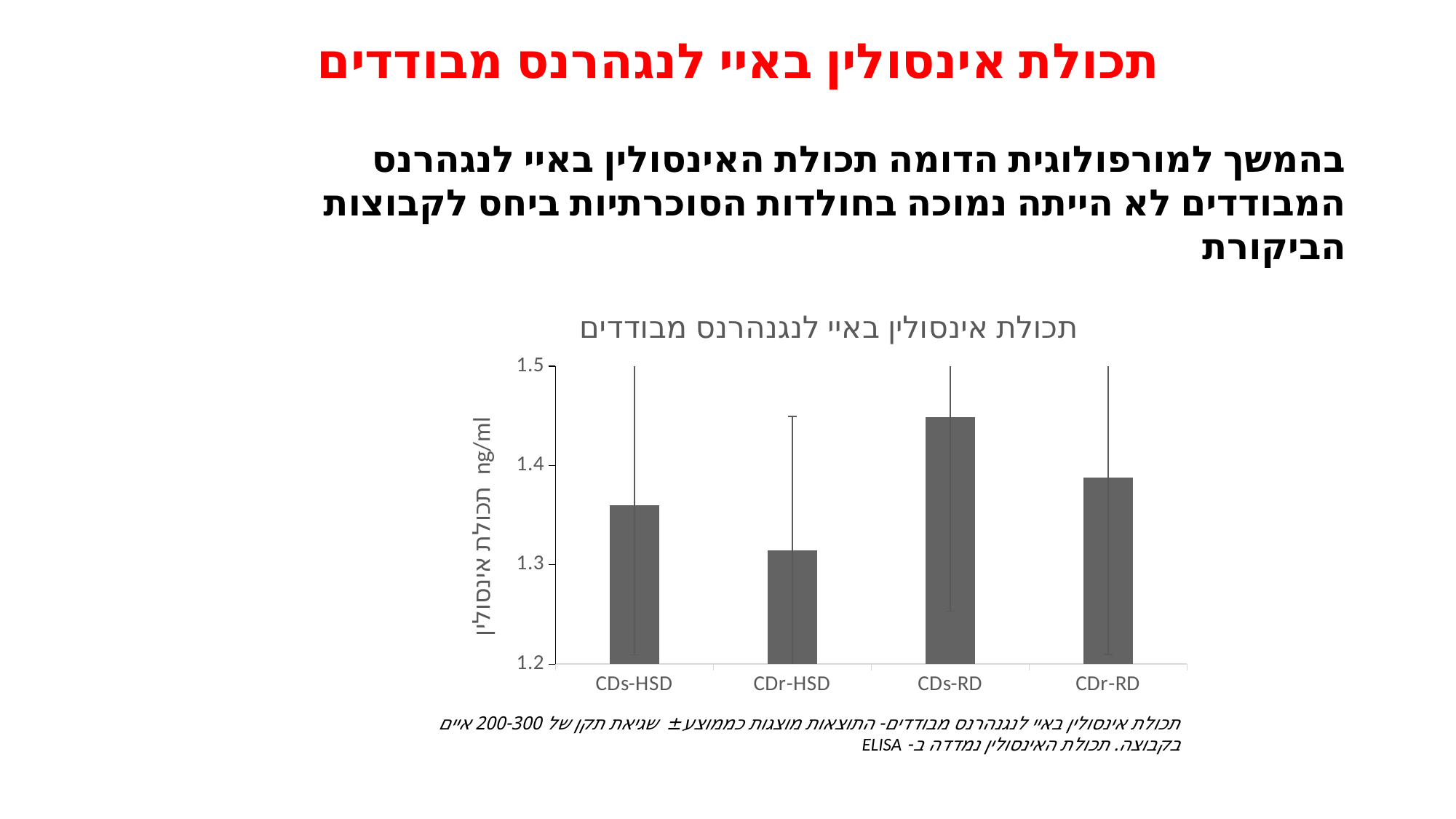
Which is larger, the value for CDs-RD or the value for CDr-RD? CDs-RD Is the value for CDs-RD greater or less than 1.4? greater Which category has the lowest bar in the chart? CDr-HSD Which is larger, the value for CDs-HSD or the value for CDr-HSD? CDs-HSD Is the value for CDs-HSD greater or less than 1.3? greater Which category has the highest bar in the chart? CDs-RD What kind of chart is shown on the slide? bar chart How many categories are plotted on the x axis of the chart? 4 Is the value for CDr-HSD greater or less than 1.4? less What unit is shown on the y-axis label of the chart? ng/ml What is the title of the chart? תכולת אינסולין באיי לנגנהרנס מבודדים